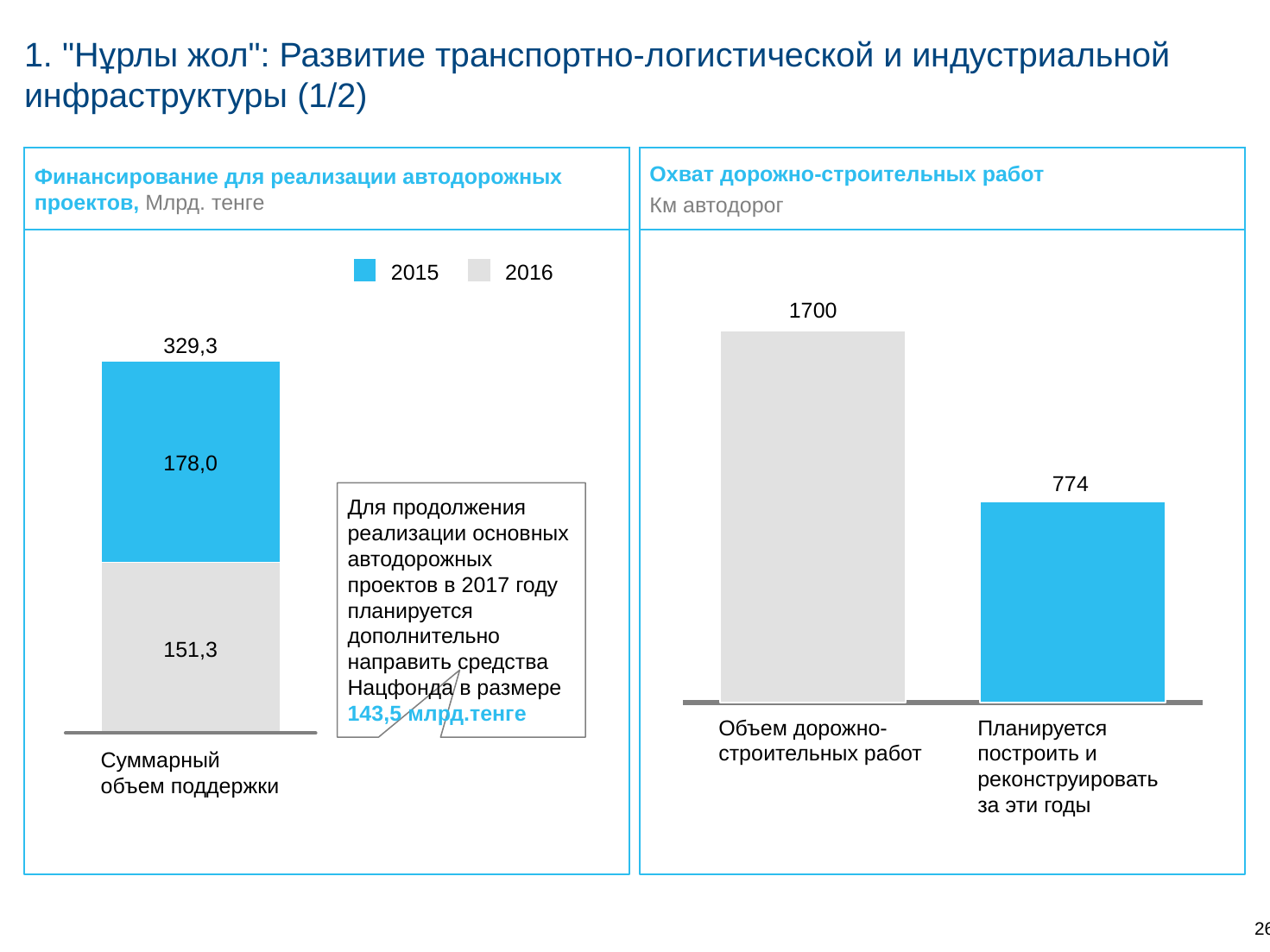
In the left chart (Финансирование для реализации автодорожных проектов), what is the value for 2016? 151,3 How many series does the legend of the left chart (Финансирование для реализации автодорожных проектов) list? 2 In the left chart (Финансирование для реализации автодорожных проектов), which colour represents 2016? Grey What kind of chart is the right chart (Охват дорожно-строительных работ)? Bar chart In the right chart (Охват дорожно-строительных работ), what is the difference between the two bars? 926 In the left chart (Финансирование для реализации автодорожных проектов), which year has the larger value, 2015 or 2016? 2015 In the left chart (Финансирование для реализации автодорожных проектов), what is the value for 2015? 178,0 In the right chart (Охват дорожно-строительных работ), what is the value for Объем дорожно-строительных работ? 1700 In the left chart (Финансирование для реализации автодорожных проектов), what is the total of the stacked bar for Суммарный объем поддержки? 329,3 In the right chart (Охват дорожно-строительных работ), which category has the highest value? Объем дорожно-строительных работ In the right chart (Охват дорожно-строительных работ), what is the value for Планируется построить и реконструировать за эти годы? 774 In the left chart (Финансирование для реализации автодорожных проектов), what is the difference between the 2015 and 2016 values? 26,7